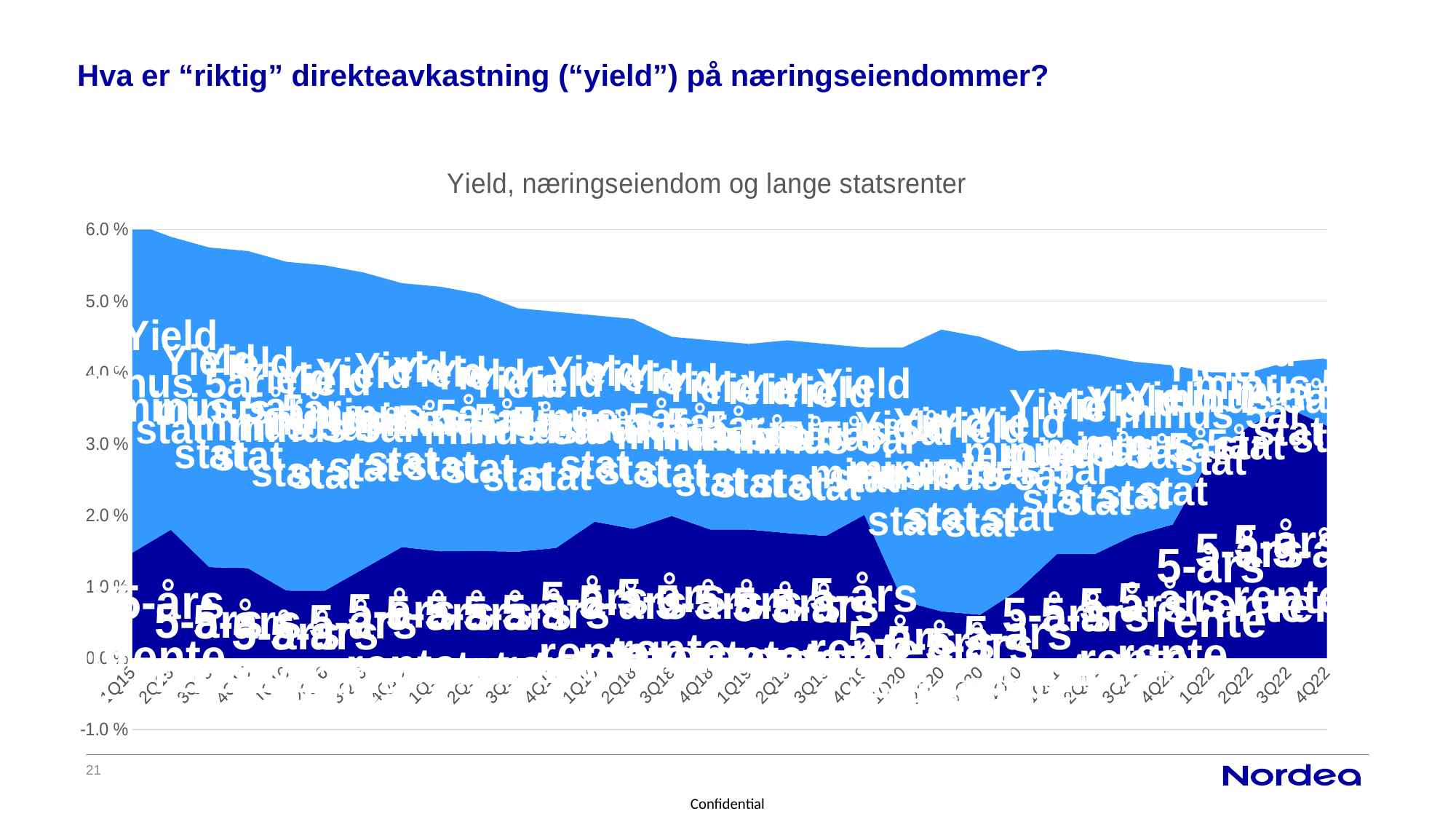
What kind of chart is shown on the slide? Area chart Is the total stacked value at 4Q22 greater or less than 5.0 %? less Is the value of the 5-års rente series at 2Q20 greater or less than 1.0 %? less Which quarter has the highest total stacked value in the chart? 1Q15 How many data series are plotted in the chart? 2 Does the total stacked value generally rise or fall from 1Q15 to 4Q22? fall How many quarters are shown on the x axis of the chart? 32 Is the value of the 5-års rente series at 4Q22 greater or less than 2.0 %? greater What is the title of the chart? Yield, næringseiendom og lange statsrenter Is the total stacked value larger at 1Q15 or at 4Q22? 1Q15